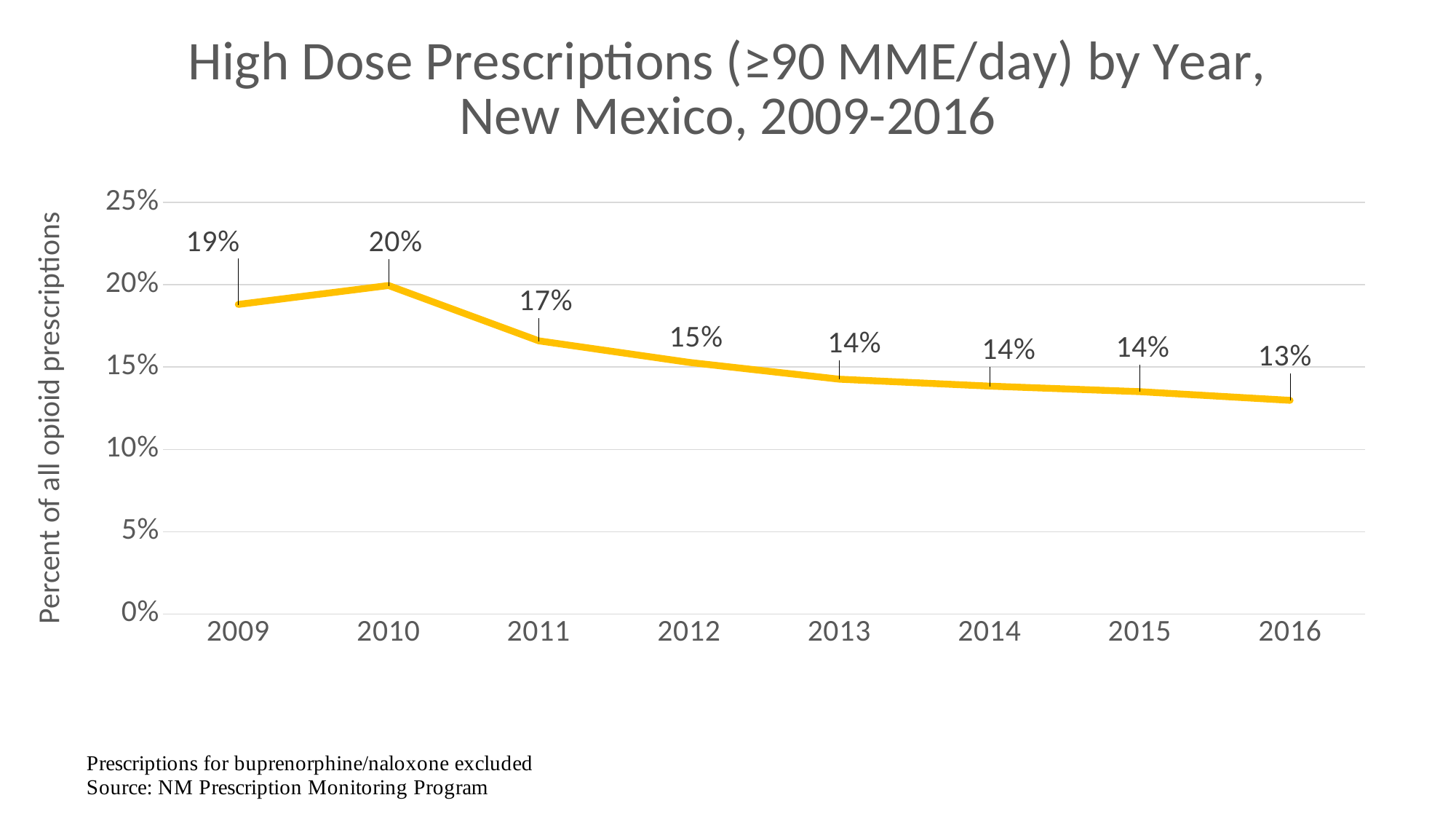
Do the values rise or fall from 2010 to 2016? fall Which year has the lowest value? 2016 What is the difference between the values for 2010 and 2016? 7% What is the value for 2016? 13% Which is larger, the value for 2011 or the value for 2013? 2011 Is the value for 2012 greater or less than 20%? less What is the label on the vertical axis? Percent of all opioid prescriptions What is the value for 2012? 15% What is the value for 2009? 19% How many years are plotted on the chart? 8 Which year has the highest value? 2010 What kind of chart is this? line chart